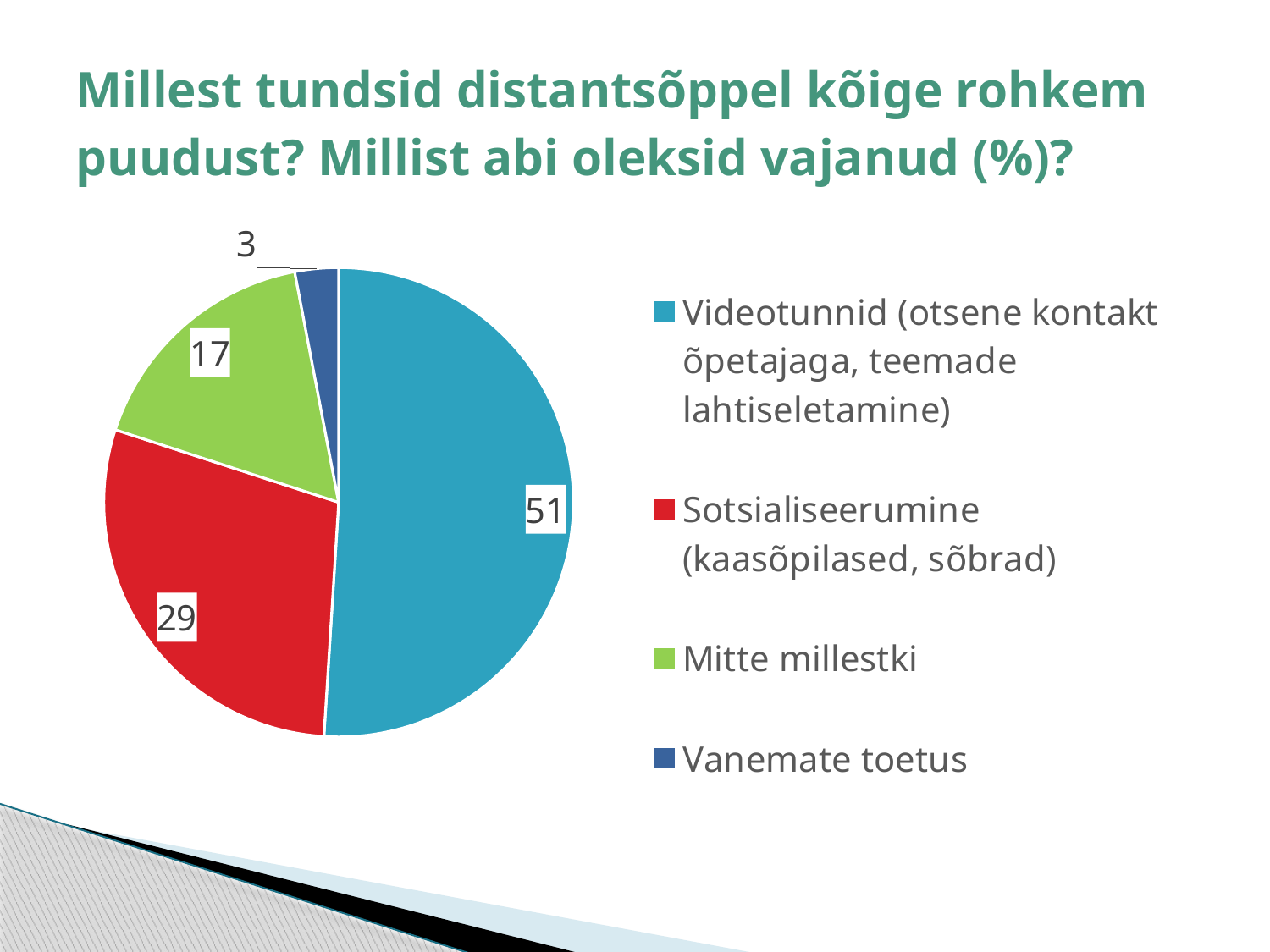
What value is shown for the Vanemate toetus slice? 3 Which is larger, the value for Sotsialiseerumine (kaasõpilased, sõbrad) or the value for Mitte millestki? Sotsialiseerumine (kaasõpilased, sõbrad) What is the difference between the values for Mitte millestki and Vanemate toetus? 14 What value is shown for the Sotsialiseerumine (kaasõpilased, sõbrad) slice? 29 Which category has the smallest slice of the pie? Vanemate toetus What colour is the Mitte millestki slice? Green What kind of chart is shown on the slide? Pie chart Which category has the largest slice of the pie? Videotunnid (otsene kontakt õpetajaga, teemade lahtiseletamine) How many slices does the pie chart have? 4 What value is shown for the Mitte millestki slice? 17 What is the difference between the values for Videotunnid and Sotsialiseerumine? 22 What value is shown for the Videotunnid (otsene kontakt õpetajaga, teemade lahtiseletamine) slice? 51